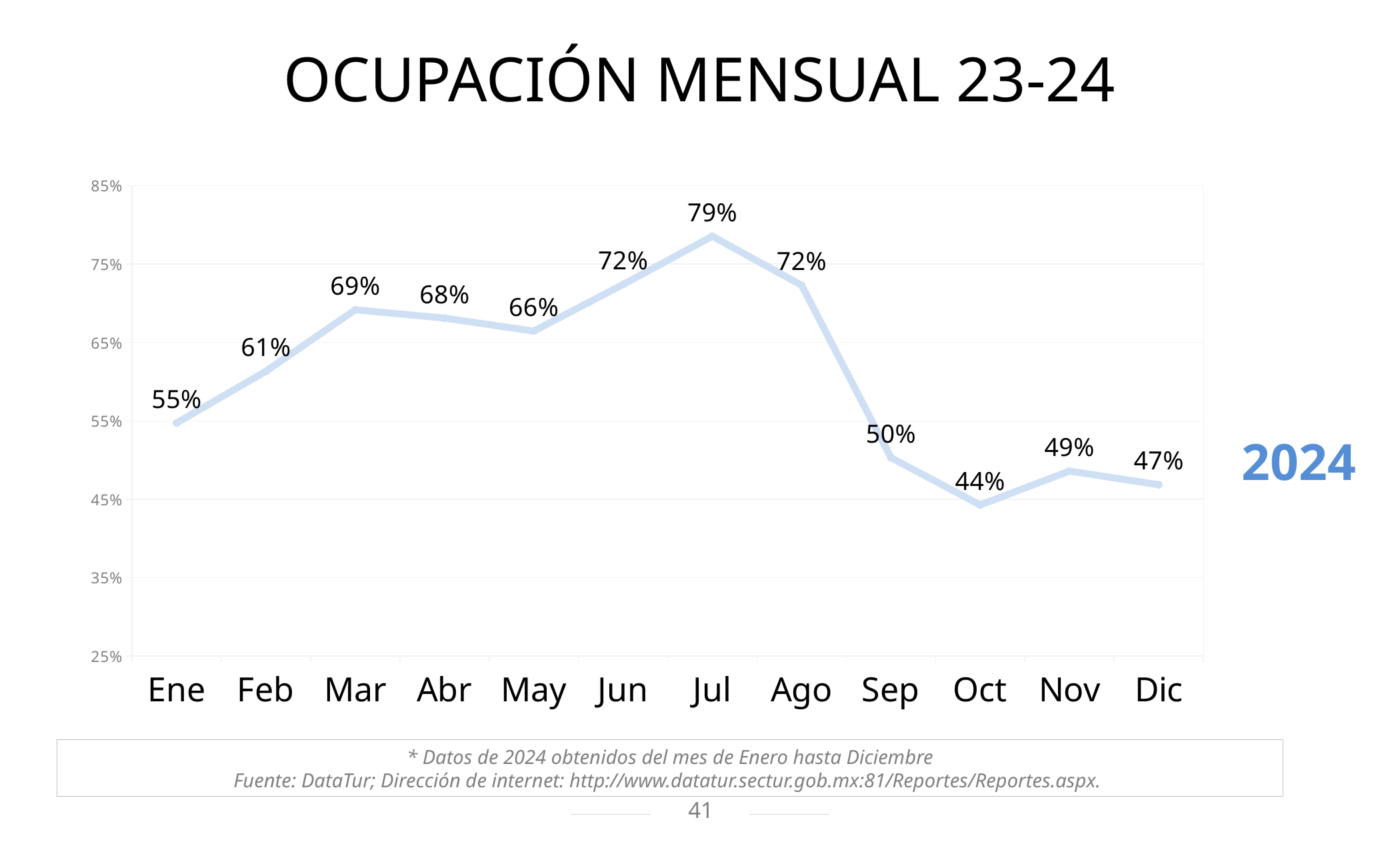
What is the occupancy value for Jul? 79% What is the title of the chart? OCUPACIÓN MENSUAL 23-24 What kind of chart is shown on the slide? Line chart What is the difference between the occupancy in Jul and in Oct? 35% Which month has the lowest occupancy? Oct Which month has the highest occupancy? Jul Do the values rise or fall from Ago to Oct? Fall What is the occupancy value for Oct? 44% What is the occupancy value for Ene? 55% What is the difference between the occupancy in Mar and in Feb? 8% Which is larger, the occupancy in Sep or in Dic? Sep How many months are plotted on the chart? 12